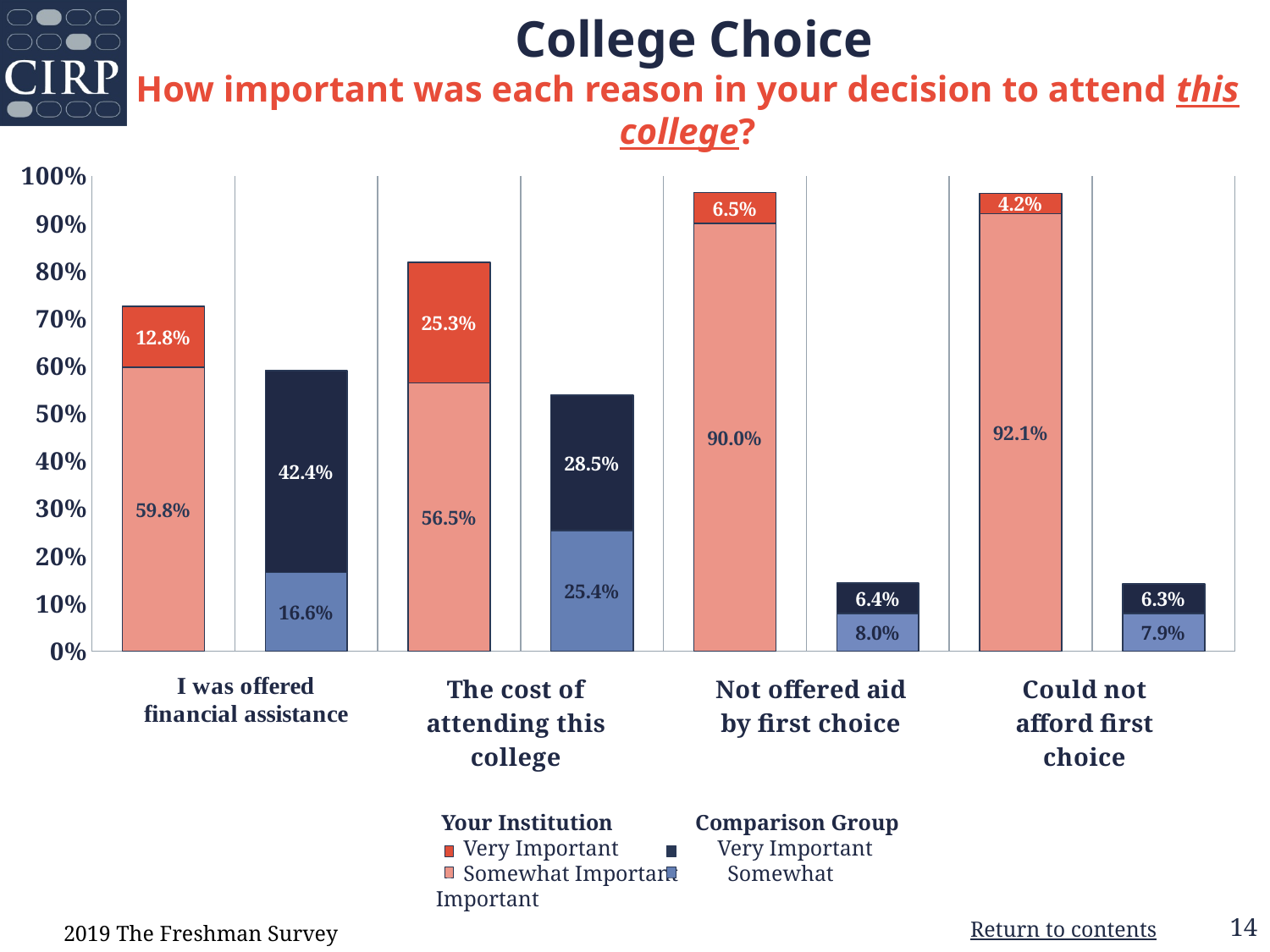
Which reason has the lowest Your Institution Very Important value? Could not afford first choice For "The cost of attending this college", which is larger: the Your Institution Somewhat Important value or the Comparison Group Somewhat Important value? Your Institution Somewhat Important What is the total height of the Comparison Group stacked bar for "I was offered financial assistance"? 59.0% What is the total height of the Your Institution stacked bar for "The cost of attending this college"? 81.8% How many reasons (categories) are shown on the x axis of the chart? 4 What is the difference between the Comparison Group Very Important value and the Your Institution Very Important value for "I was offered financial assistance"? 29.6% What percentage of the Comparison Group rated "The cost of attending this college" as Somewhat Important? 25.4% How many series does the chart legend list? 4 What percentage of the Comparison Group rated "Could not afford first choice" as Very Important? 6.3% What percentage of Your Institution students rated "I was offered financial assistance" as Very Important? 12.8% What percentage of Your Institution students rated "Not offered aid by first choice" as Somewhat Important? 90.0% Which reason has the highest Comparison Group Very Important value? I was offered financial assistance